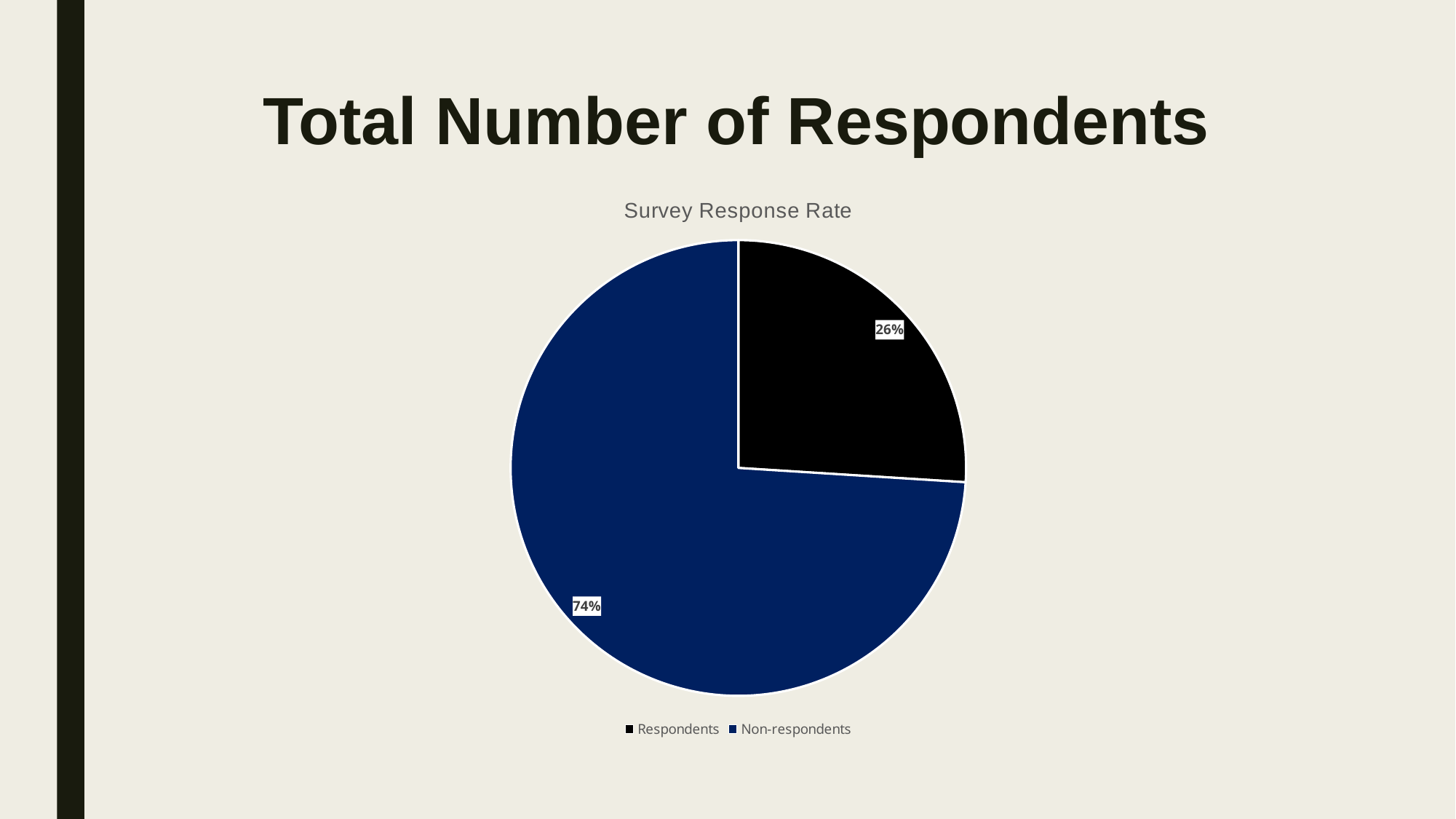
What kind of chart is shown on the slide? pie chart Which is larger, Respondents or Non-respondents? Non-respondents How many entries does the legend list? 2 What colour is the Non-respondents slice? dark blue What share of the pie is Non-respondents? 74% How many slices does the pie chart have? 2 What share of the pie is Respondents? 26% What is the difference in percentage points between Non-respondents and Respondents? 48 Which slice is the largest? Non-respondents Which slice is the smallest? Respondents What is the title of the chart? Survey Response Rate